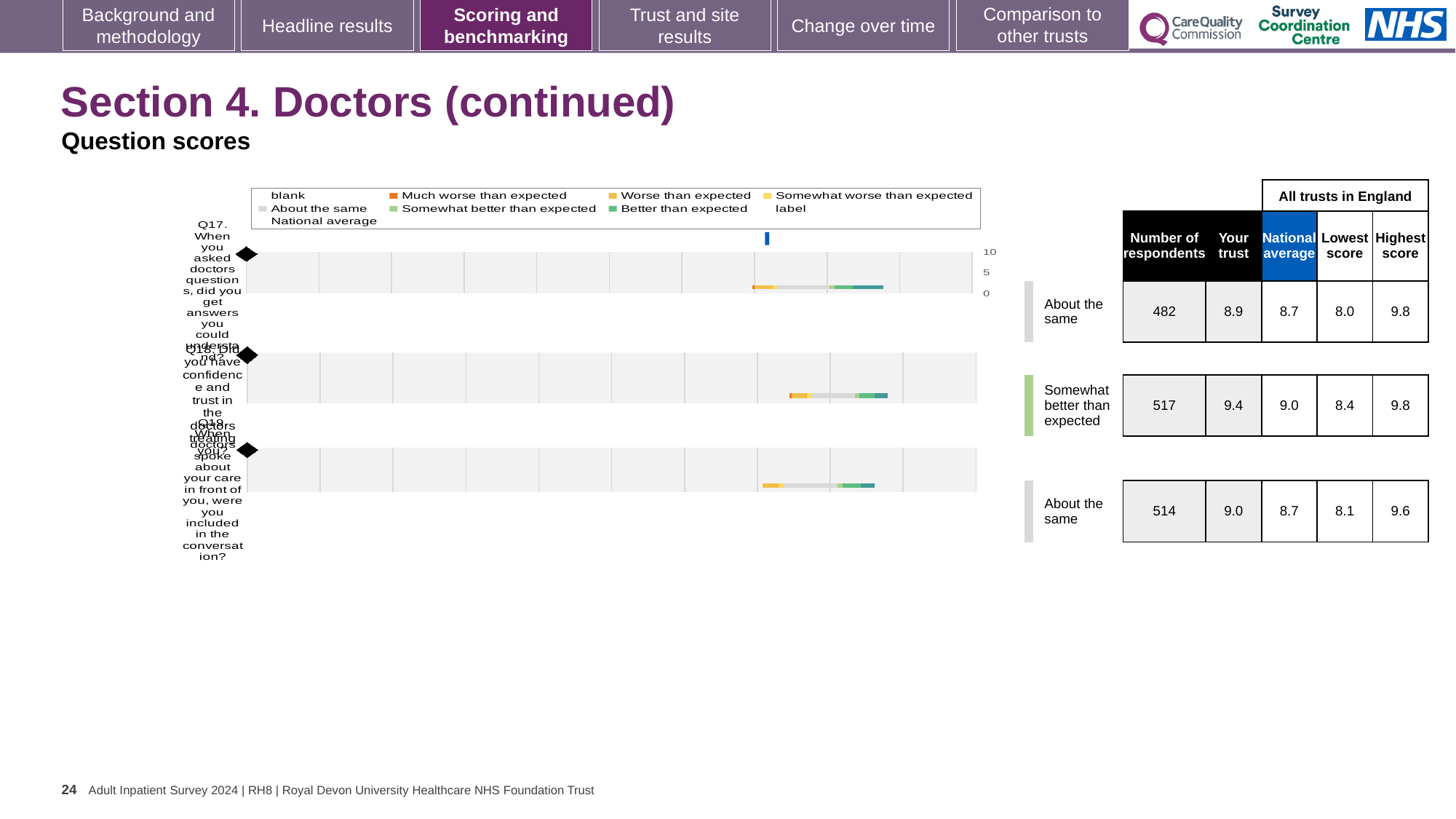
Which question has the highest 'Your trust' score? Q18 How many respondents answered Q17? 482 What is the national average score for Q19 (When doctors spoke about your care in front of you, were you included in the conversation)? 8.7 What is the difference between the 'Your trust' score and the national average for Q18? 0.4 What kind of chart is used to show the question scores? bar chart What is the 'Your trust' score for Q18 (Did you have confidence and trust in the doctors treating you)? 9.4 How many survey questions are plotted as rows in the chart? 3 What is the highest score among all trusts in England for Q19? 9.6 For Q17, which is larger: the 'Your trust' score or the national average? Your trust (8.9) What is the 'Your trust' score for Q17 (When you asked doctors questions, did you get answers you could understand)? 8.9 Is the 'Your trust' score for Q19 greater or less than 5 on the chart axis? greater Which benchmark category is Q18 placed in? Somewhat better than expected